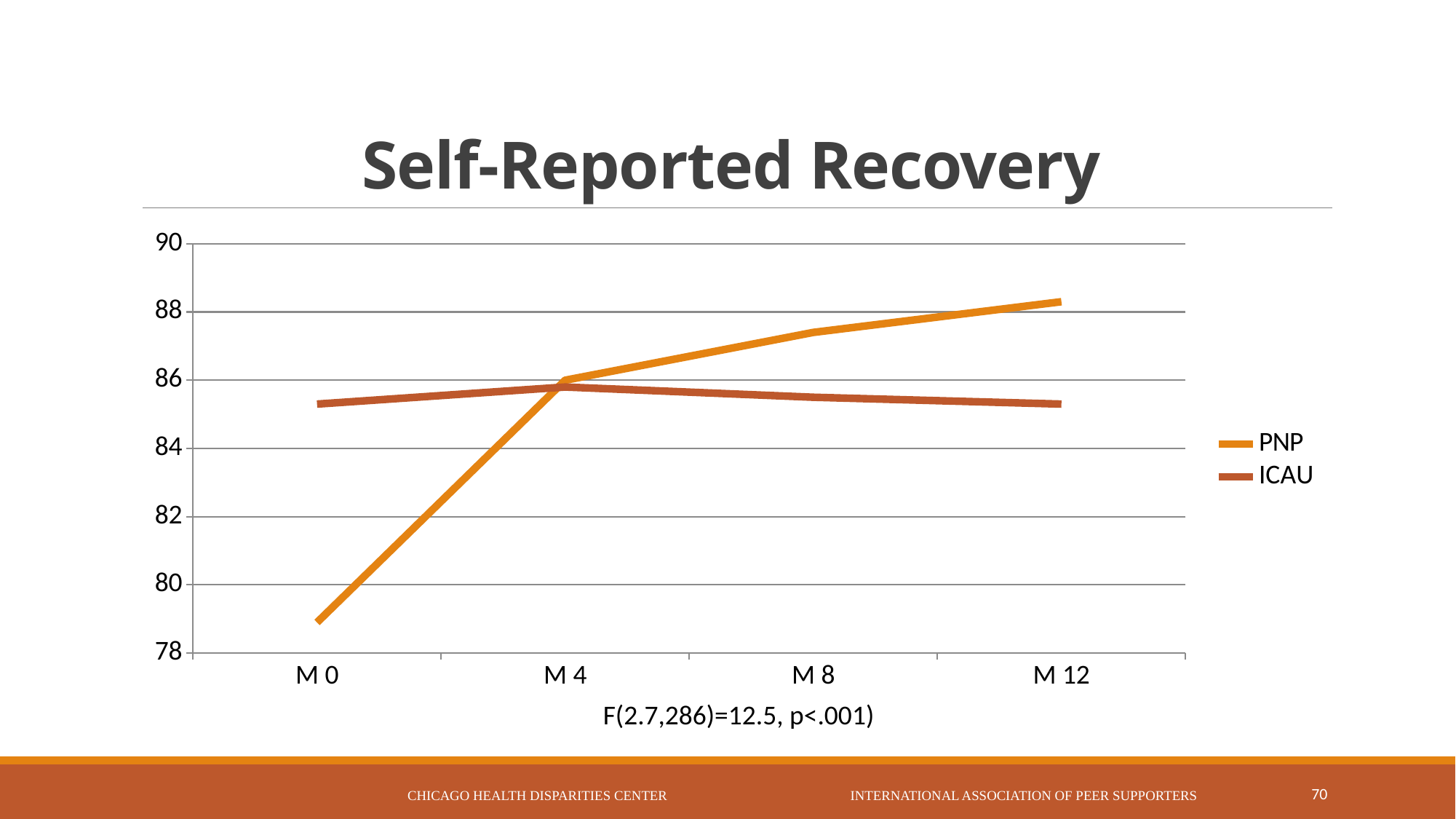
Is the ICAU value at M 0 greater or less than 86? less At M 0, which series has the higher value, PNP or ICAU? ICAU Is the ICAU value at M 12 greater or less than 84? greater What kind of chart is shown on the slide? line chart Does the PNP series rise or fall from M 0 to M 12? rise At which time point is the PNP series lowest? M 0 How many series does the legend list? 2 At which time point is the PNP series highest? M 12 Is the PNP value at M 8 greater or less than 86? greater How many time points are plotted along the x axis? 4 At M 12, which series has the higher value, PNP or ICAU? PNP